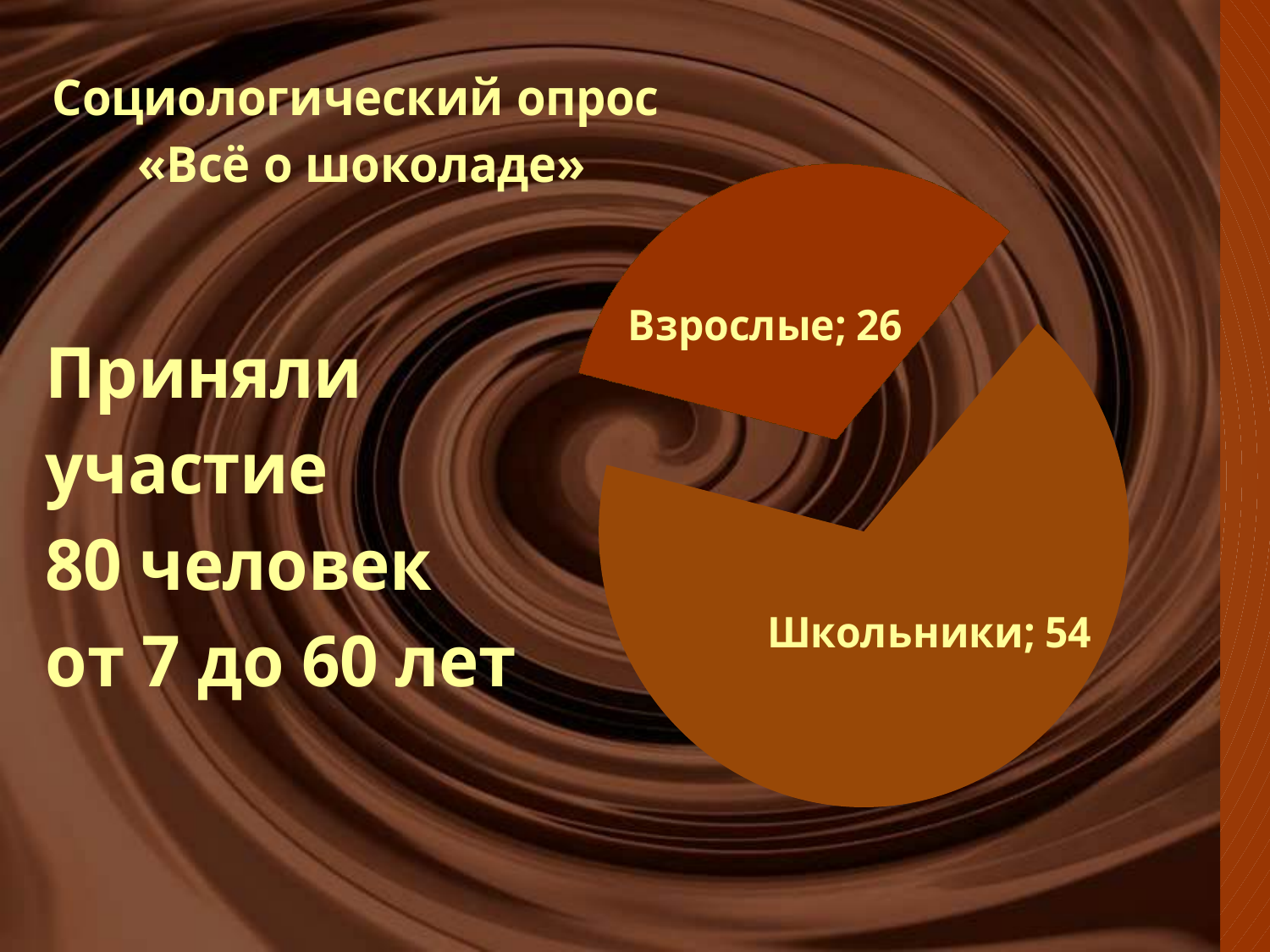
What kind of chart is shown on the slide? pie chart Which is larger, the value for Школьники or the value for Взрослые? Школьники What share of the pie does the Школьники slice represent? 67.5% Which category has the largest slice in the pie chart? Школьники What share of the pie does the Взрослые slice represent? 32.5% What is the title of the survey shown on the slide? Социологический опрос «Всё о шоколаде» What is the total of the two slices in the pie chart? 80 What is the difference between the values for Школьники and Взрослые? 28 What is the value for Взрослые in the pie chart? 26 Which category has the smallest slice in the pie chart? Взрослые What is the value for Школьники in the pie chart? 54 How many slices does the pie chart have? 2